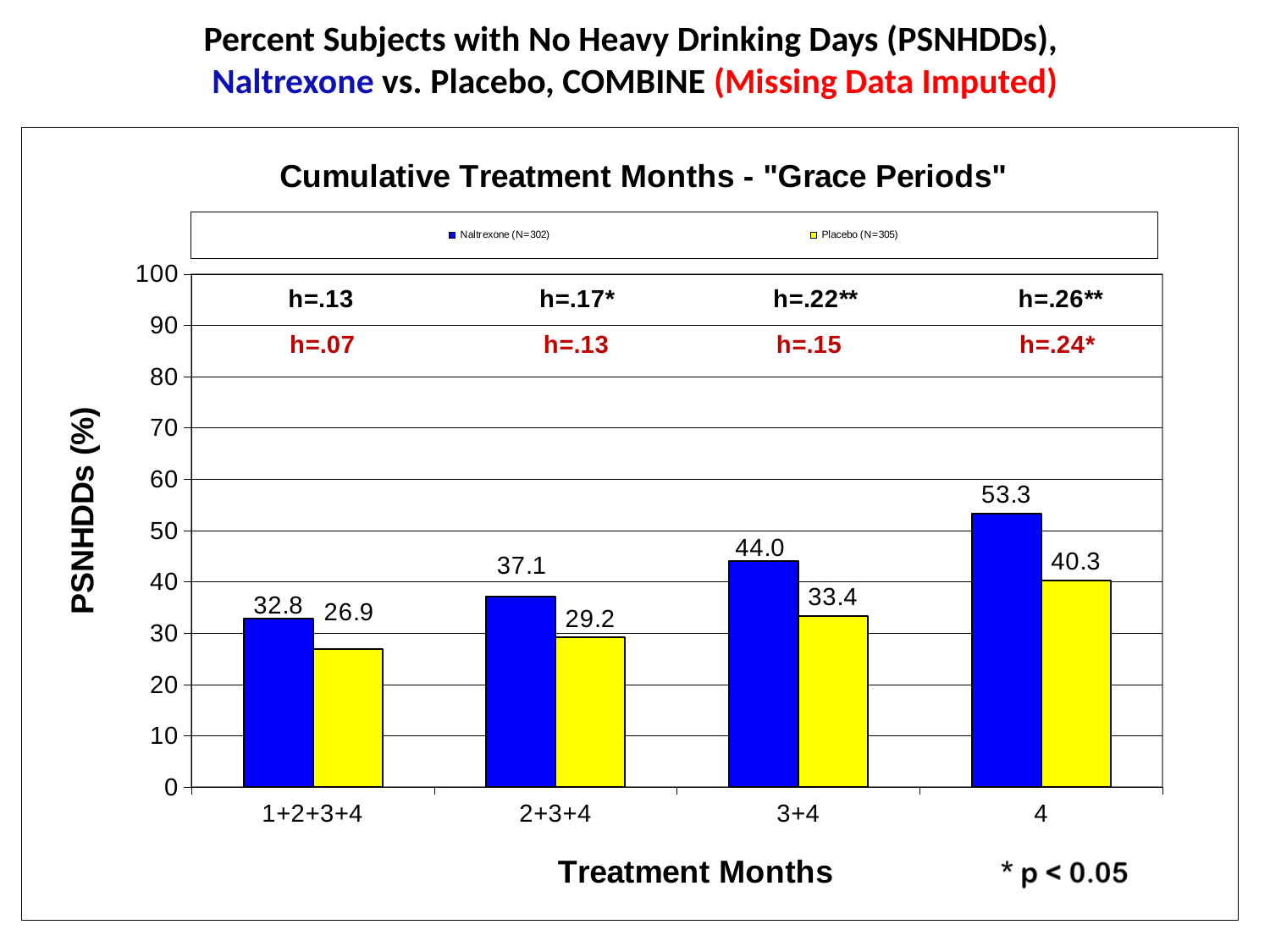
What is the difference between the Naltrexone and Placebo values for the 4 treatment months category? 13.0 What is the Placebo value for the 1+2+3+4 treatment months category? 26.9 What is the Placebo value for the 3+4 treatment months category? 33.4 Which treatment months category has the highest Naltrexone value? 4 Which treatment months category has the lowest Placebo value? 1+2+3+4 How many series does the legend list? 2 What is the difference between the Naltrexone values for 2+3+4 and 1+2+3+4? 4.3 Which is larger for the 3+4 category, the Naltrexone value or the Placebo value? Naltrexone What kind of chart is shown on the slide? bar chart What is the Naltrexone value for the 4 treatment months category? 53.3 Do the Naltrexone values rise or fall from 1+2+3+4 to 4 along the x axis? rise How many treatment months categories are shown on the x axis? 4